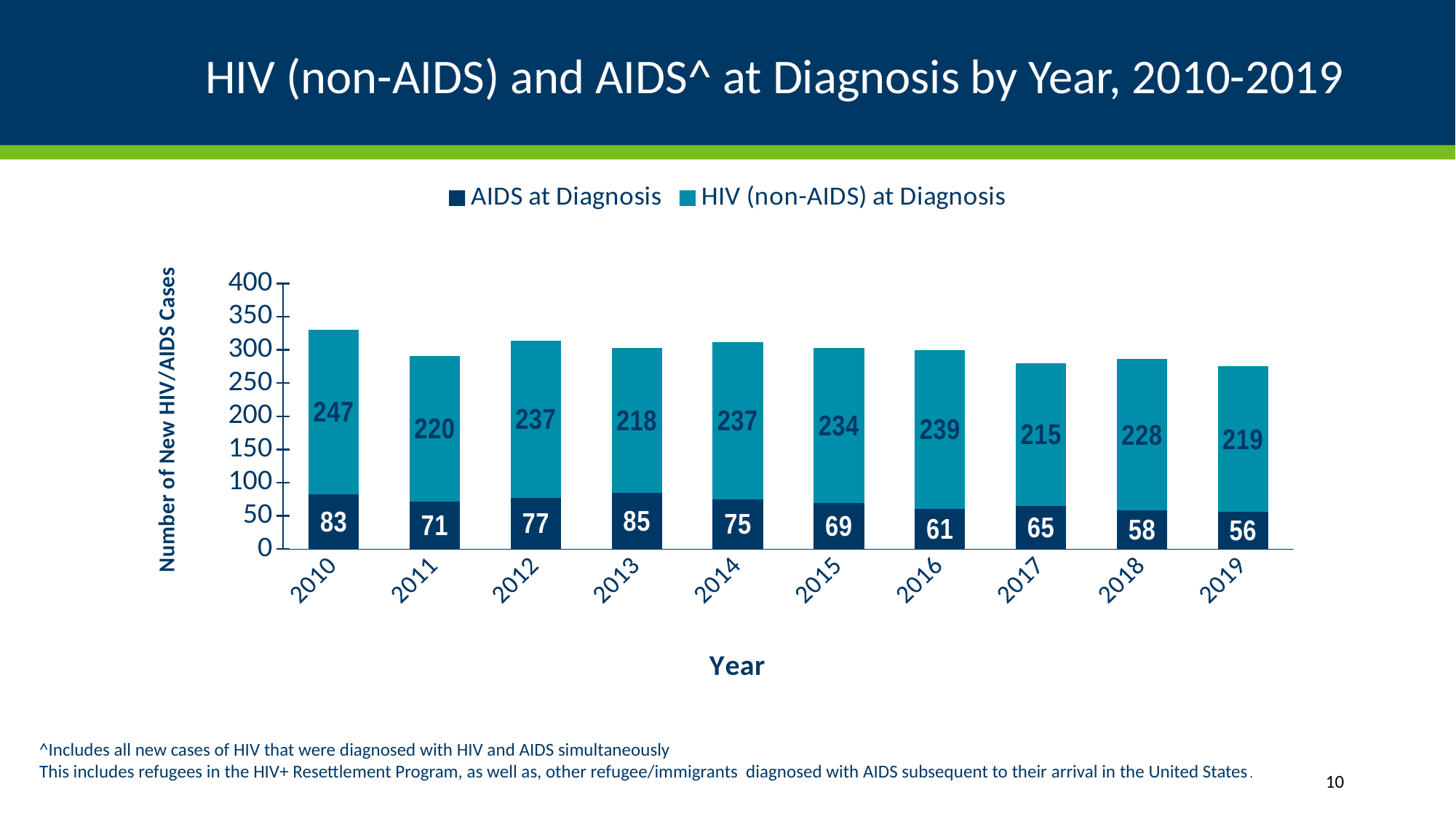
Which year has the lowest value for HIV (non-AIDS) at Diagnosis? 2017 Which is larger, the AIDS at Diagnosis value for 2012 or for 2014? 2012 How many years are shown on the x axis? 10 What kind of chart is shown on the slide? Stacked bar chart What is the total of the stacked bar for 2019? 275 Which year has the lowest value for AIDS at Diagnosis? 2019 What is the value for HIV (non-AIDS) at Diagnosis in 2016? 239 What is the total of the stacked bar for 2010? 330 What is the value for AIDS at Diagnosis in 2013? 85 What is the difference between the HIV (non-AIDS) at Diagnosis values for 2010 and 2011? 27 Which year has the highest value for AIDS at Diagnosis? 2013 How many series does the legend list? 2